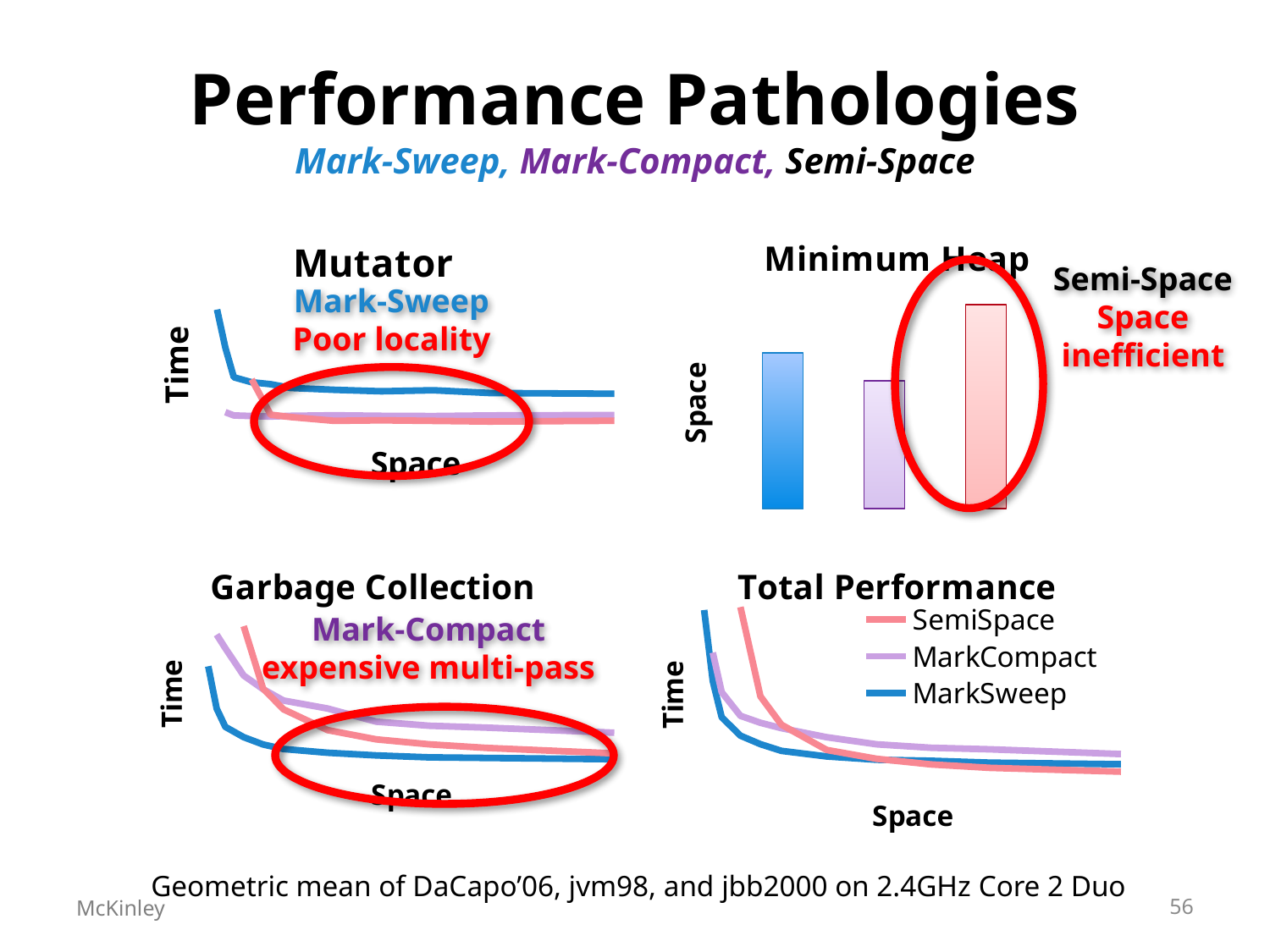
In the Total Performance chart, do the lines rise or fall as Space increases? fall In the Minimum Heap chart, is the blue bar taller or shorter than the purple bar? taller In the Minimum Heap chart, which bar is the shortest? the purple (Mark-Compact) bar In the Minimum Heap chart, which bar is the tallest? the red (Semi-Space) bar How many bars are shown in the Minimum Heap chart? 3 In the Mutator chart, which line stays highest (most Time) at large Space values? Mark-Sweep (blue) What kind of chart is the Minimum Heap chart? bar chart What kind of chart is the Total Performance chart? line chart What is the label on the y-axis of the Minimum Heap chart? Space How many series does the legend of the Total Performance chart list? 3 Which series is shown in blue in the Total Performance chart legend? MarkSweep In the Garbage Collection chart, does the Time for each collector rise or fall as Space increases? fall